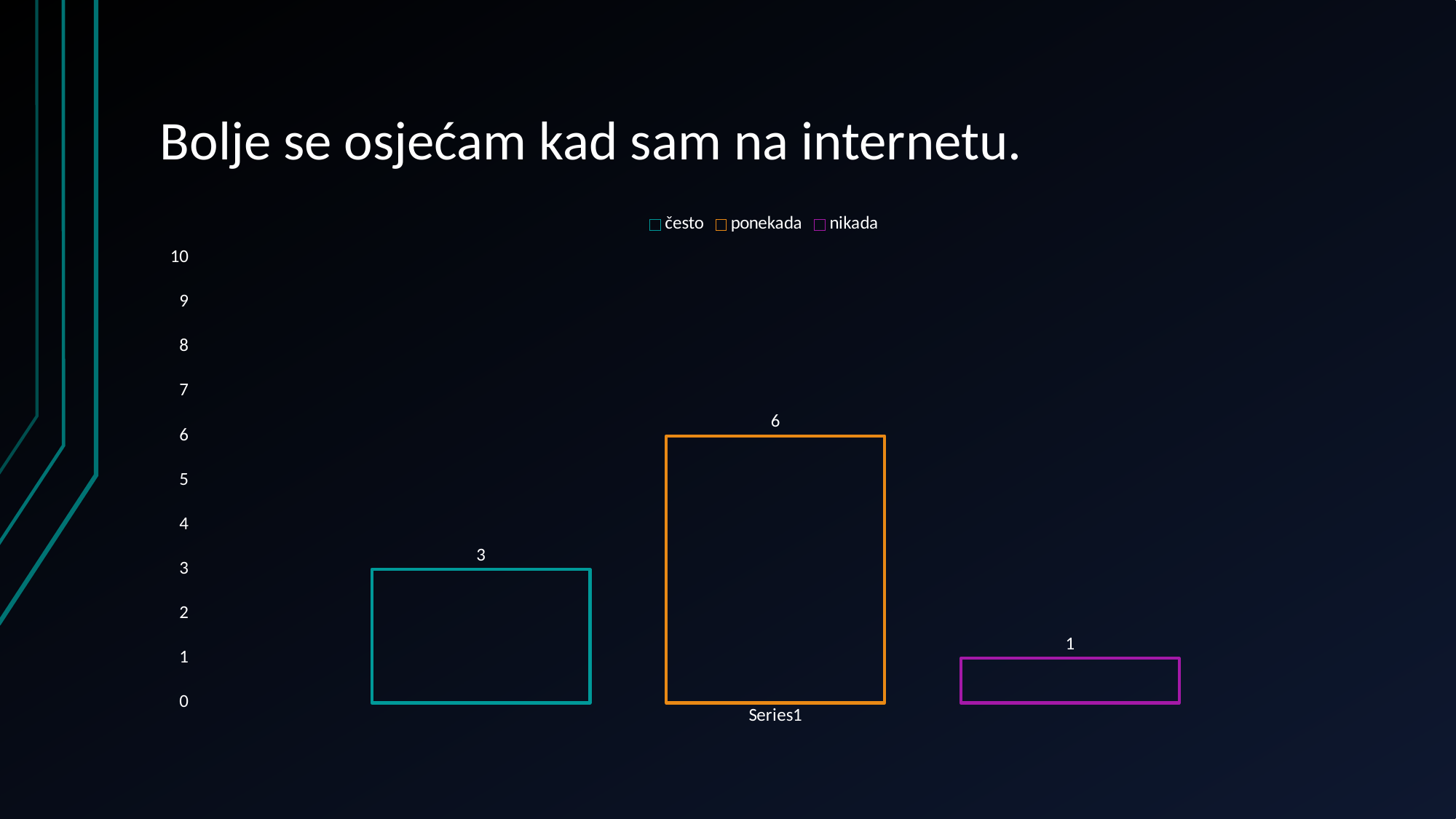
Which series has the lowest value? nikada What is the difference between the values for "ponekada" and "često"? 3 How many series does the legend list? 3 Which is larger, the value for "često" or the value for "nikada"? često What is the value for "često"? 3 What is the value for "ponekada"? 6 What is the value for "nikada"? 1 What kind of chart is shown on the slide? bar chart What is the title of the slide above the chart? Bolje se osjećam kad sam na internetu. What is the difference between the values for "često" and "nikada"? 2 Is the value for "ponekada" greater or less than 5? greater Which series has the highest value? ponekada